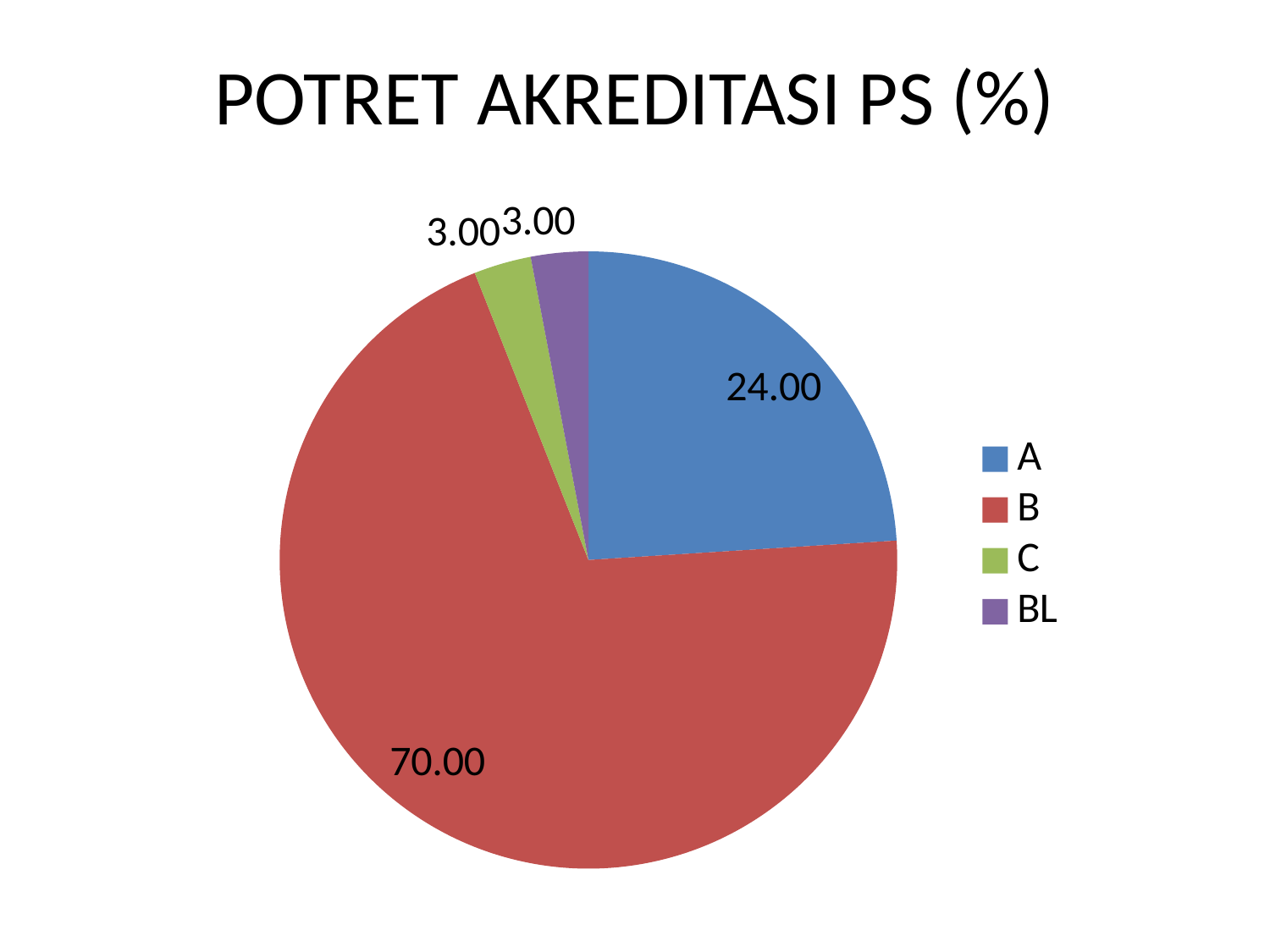
What is the difference between the values for A and C? 21.00 What is the value for category B in the pie chart? 70.00 What is the value for category BL in the pie chart? 3.00 Which category has the largest slice of the pie? B What is the value for category C in the pie chart? 3.00 What is the title of the chart? POTRET AKREDITASI PS (%) What type of chart is shown on the slide? Pie chart What share of the pie does category B represent? 70.00% What is the value for category A in the pie chart? 24.00 What is the difference between the values for B and A? 46.00 Which is larger, the value for A or the value for BL? A How many slices does the pie chart have? 4